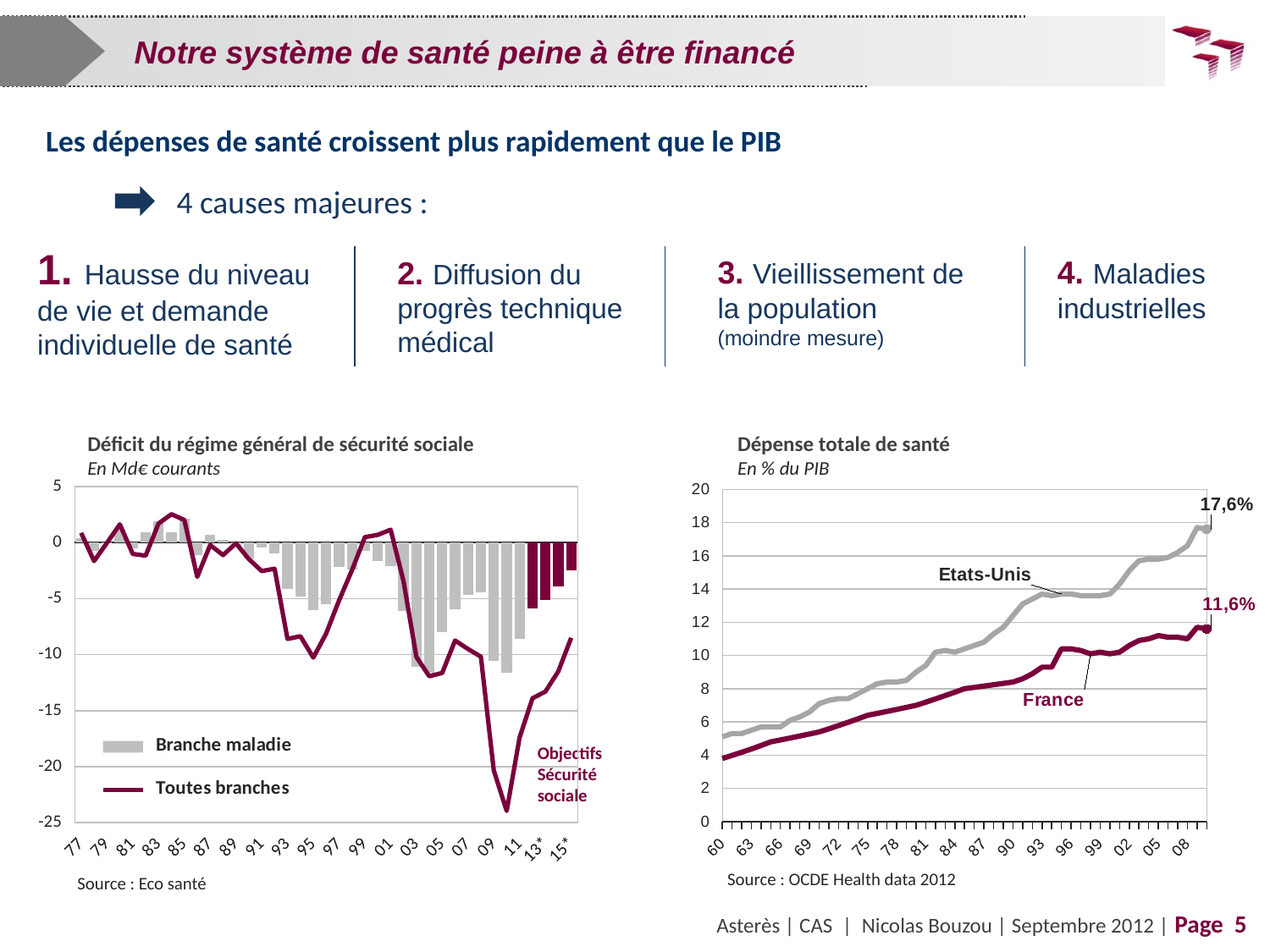
What unit is indicated under the title of the chart 'Déficit du régime général de sécurité sociale'? En Md€ courants On the chart 'Dépense totale de santé', what is the final value shown for France? 11,6% On the chart 'Dépense totale de santé', do the values for France rise or fall from 1960 to 2008? Rise On the chart 'Dépense totale de santé', what is the difference between the final labelled values for Etats-Unis and France? 6 points On the chart 'Déficit du régime général de sécurité sociale', is the value for Toutes branches in 2010 greater or less than -20? less On the chart 'Déficit du régime général de sécurité sociale', in which year does the Toutes branches line reach its lowest point? 2010 On the chart 'Dépense totale de santé', which series ends higher, Etats-Unis or France? Etats-Unis What kind of chart is 'Dépense totale de santé'? Line chart On the chart 'Dépense totale de santé', what is the final value shown for Etats-Unis? 17,6% On the chart 'Déficit du régime général de sécurité sociale', how many series does the legend list? 2 On the chart 'Dépense totale de santé', how many series are plotted? 2 On the chart 'Dépense totale de santé', is the value for Etats-Unis in 1990 greater or less than 10? greater